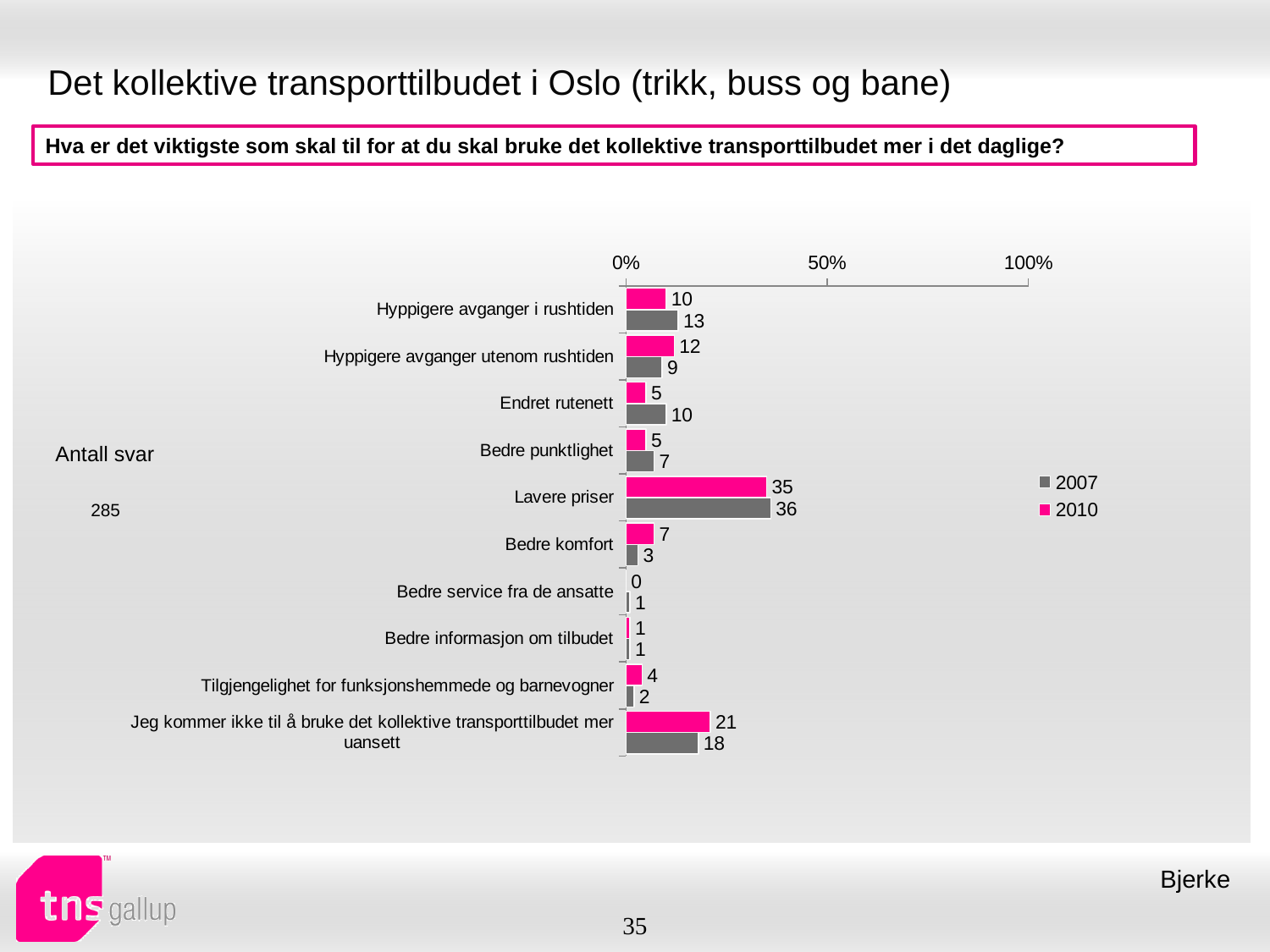
How many series does the legend list? 2 Which colour represents the 2010 series in the legend? Pink What is the 2007 value for Hyppigere avganger i rushtiden? 13 Is the 2007 value for Lavere priser greater or less than 50%? less How many categories are shown on the chart? 10 Which is larger for Bedre komfort, the 2007 value or the 2010 value? 2010 What kind of chart is shown on the slide? Bar chart What is the 2010 value for Lavere priser? 35 What is the difference between the 2007 and 2010 values for Endret rutenett? 5 What is the 2010 value for Jeg kommer ikke til å bruke det kollektive transporttilbudet mer uansett? 21 Which category has the lowest 2010 value? Bedre service fra de ansatte Which category has the highest 2007 value? Lavere priser